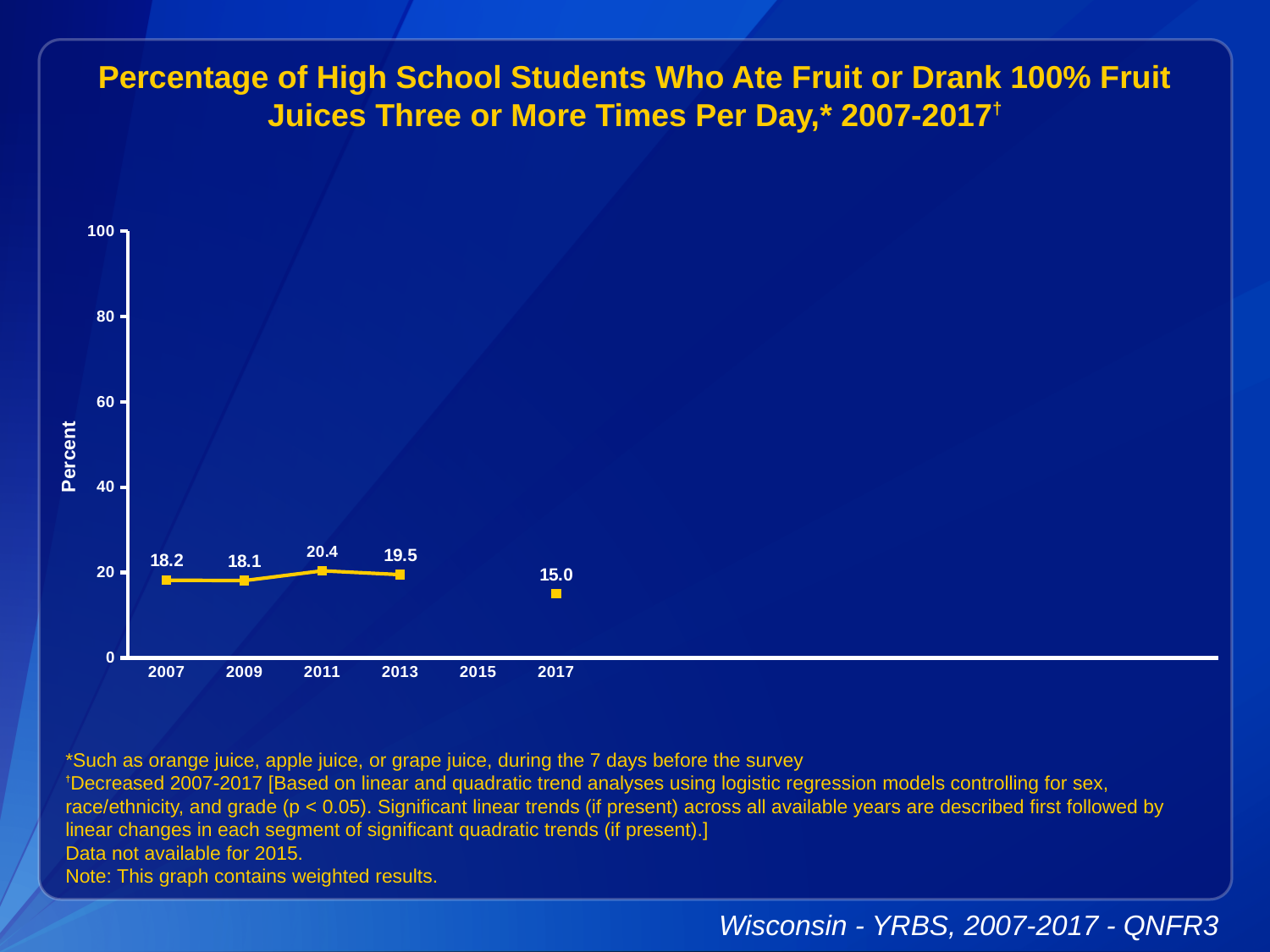
What is the difference between the 2011 value and the 2017 value? 5.4 Is the value for 2011 greater or less than 40? less What value is plotted for 2011? 20.4 Which year has the highest plotted value? 2011 How many years have a data point plotted on the chart? 5 Did the plotted value rise or fall from 2013 to 2017? fall What was the percentage of high school students who ate fruit or drank 100% fruit juices three or more times per day in 2007? 18.2 What value is plotted for 2017? 15.0 Which is larger, the value for 2013 or the value for 2009? 2013 Which year has the lowest plotted value? 2017 What is the label on the y axis of the chart? Percent What kind of chart is shown on the slide? line chart